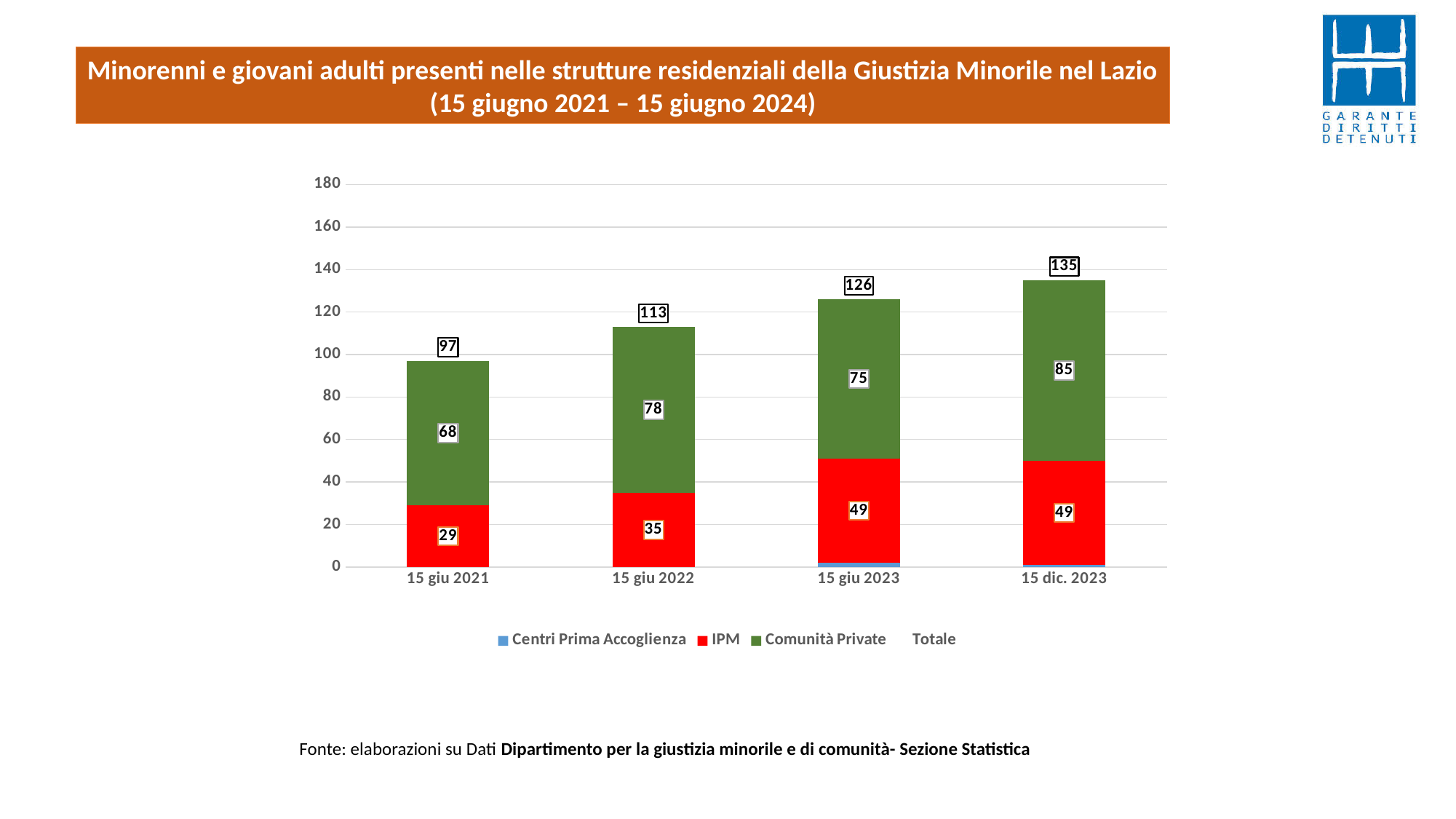
Which is larger, the Comunità Private value for 15 giu 2022 or for 15 giu 2023? 15 giu 2022 What colour represents IPM in the chart? Red What kind of chart is shown on the slide? Stacked bar chart Which date has the highest total? 15 dic. 2023 Do the totals rise or fall from 15 giu 2021 to 15 dic. 2023? Rise What is the value for Comunità Private on 15 dic. 2023? 85 What is the value for IPM on 15 giu 2021? 29 Which date has the lowest value for Comunità Private? 15 giu 2021 How many entries does the legend list? 4 What is the total shown above the bar for 15 giu 2022? 113 What is the difference between the total for 15 dic. 2023 and the total for 15 giu 2021? 38 How many dates are shown on the x axis? 4